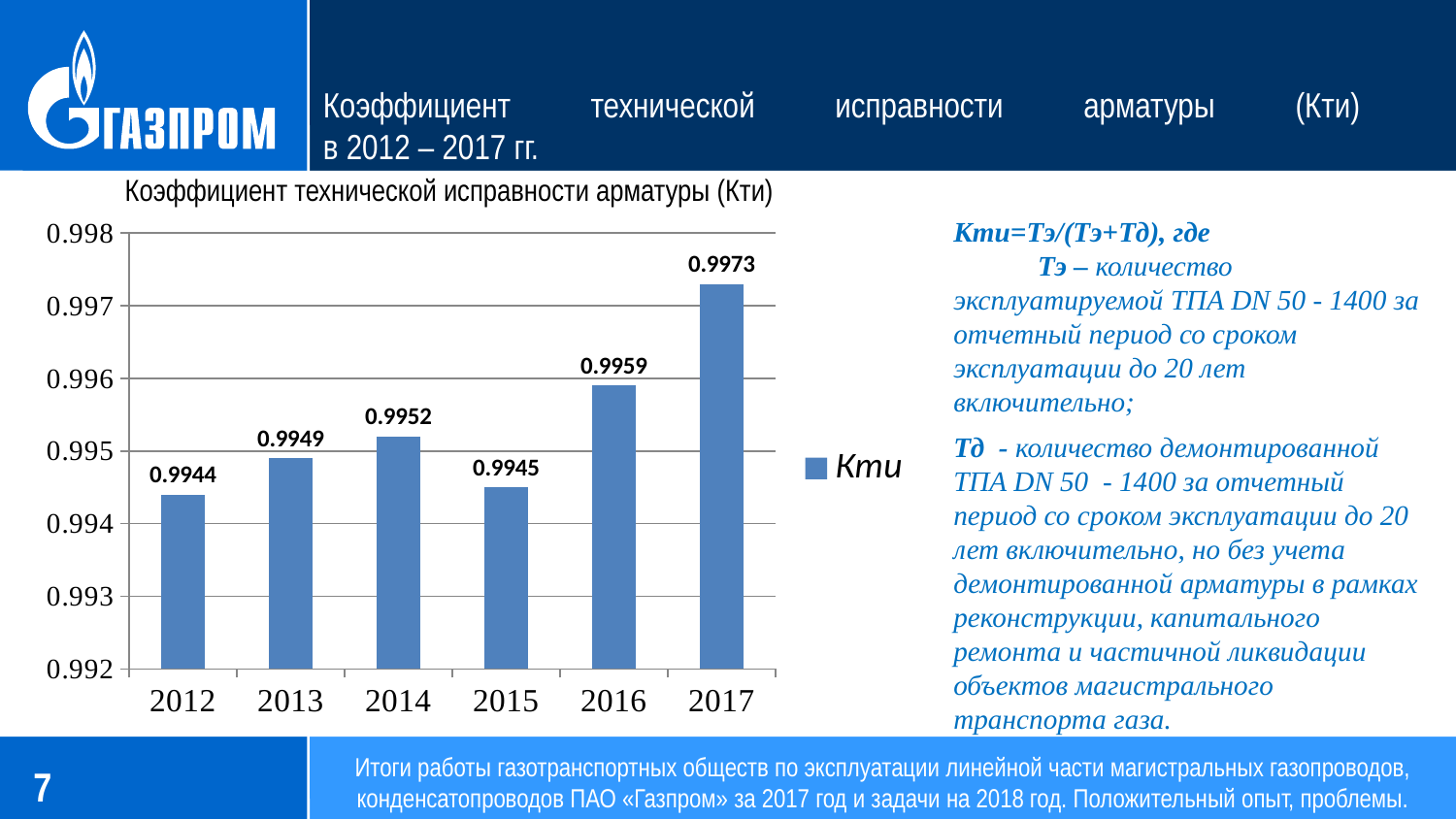
Which year has the lowest Кти value? 2012 Which year has a larger Кти value, 2014 or 2015? 2014 What is the Кти value for 2015? 0.9945 What is the title of the chart? Коэффициент технической исправности арматуры (Кти) What is the difference between the Кти values for 2017 and 2016? 0.0014 What is the Кти value for 2017? 0.9973 What kind of chart is shown on the slide? bar chart Which year has the highest Кти value? 2017 What is the Кти value for 2012? 0.9944 How many series does the chart legend list? 1 Is the Кти value for 2016 greater or less than 0.995? greater How many years are shown on the x axis of the chart? 6